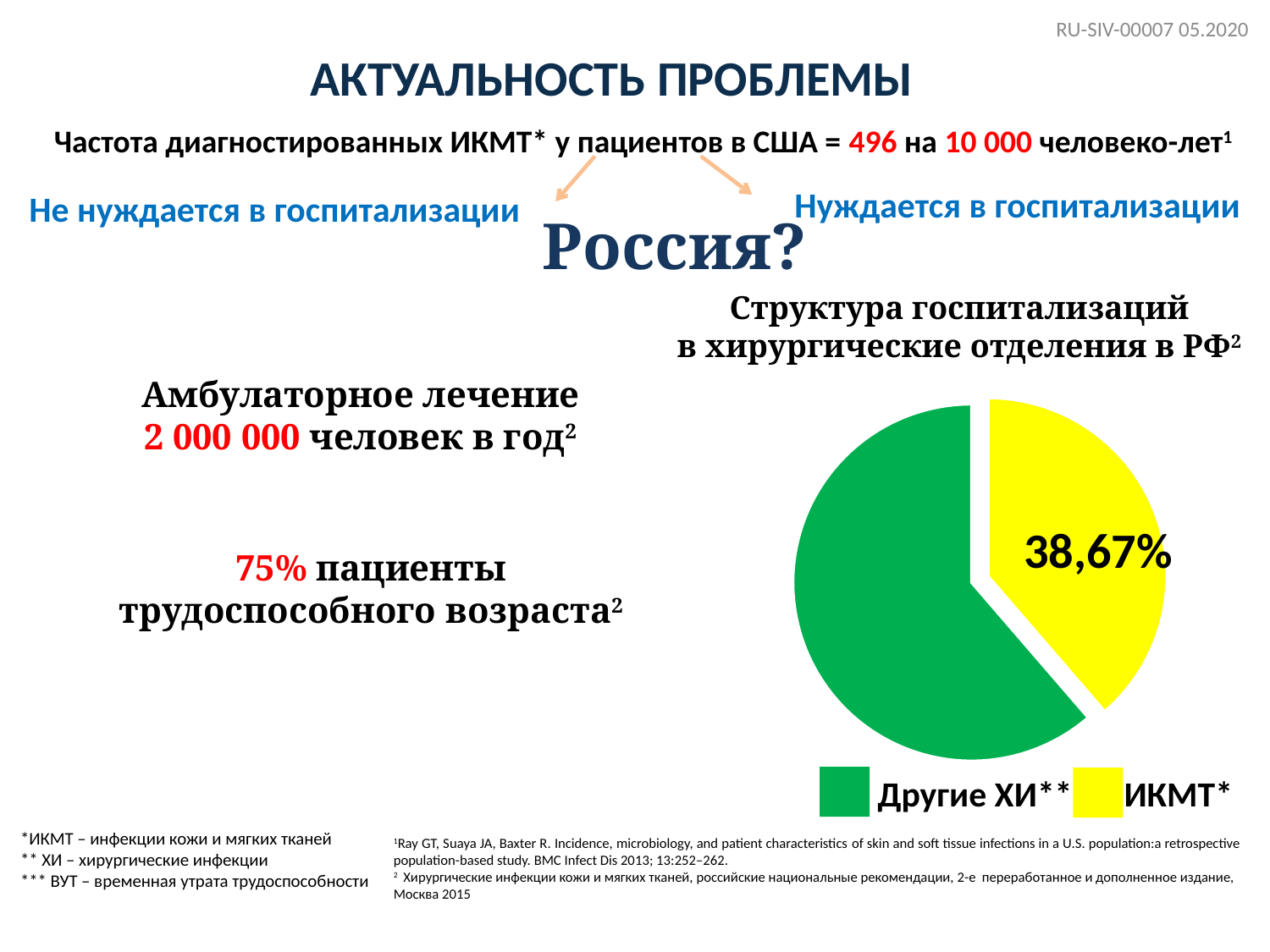
How many entries does the legend of the pie chart list? 2 What is the title of the pie chart? Структура госпитализаций в хирургические отделения в РФ Which category has the largest slice in the pie chart? Другие ХИ** How many slices does the pie chart have? 2 Which category has the smallest slice in the pie chart? ИКМТ* What colour is the ИКМТ* slice in the pie chart? yellow Is the share of the ИКМТ* slice greater or less than 50%? less What is the share of the ИКМТ* slice in the pie chart? 38,67% What kind of chart is shown on the slide? pie chart Which slice of the pie chart is larger, Другие ХИ** or ИКМТ*? Другие ХИ**